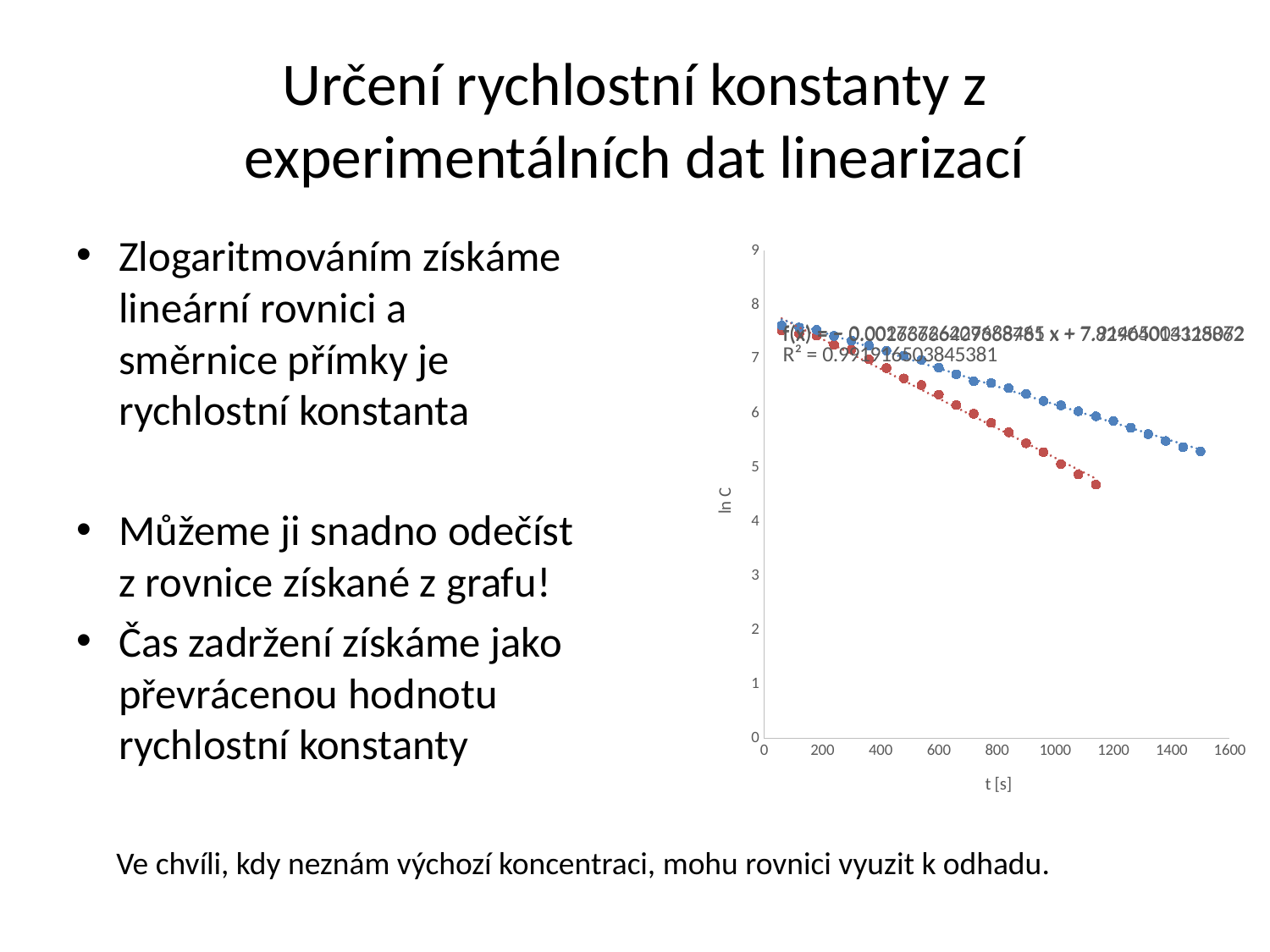
What is the label of the horizontal axis of the chart? t [s] Do the values of the red series rise or fall as t increases? fall What is the highest tick value shown on the horizontal axis? 1600 What kind of chart is shown on the slide? scatter chart What is the label of the vertical axis of the chart? ln C Is the ln C value of the last red point (near t = 1150 s) greater or less than 5? less At t = 1000 s, which series has the higher ln C value, the blue or the red one? blue Which series reaches the lower ln C value at the end of its data, the blue or the red one? red Is the ln C value of the first blue point (near t = 50 s) greater or less than 7? greater Do the values of the blue series rise or fall as t increases? fall How many data series are plotted in the chart? 2 Is the ln C value of the last blue point (near t = 1500 s) greater or less than 6? less